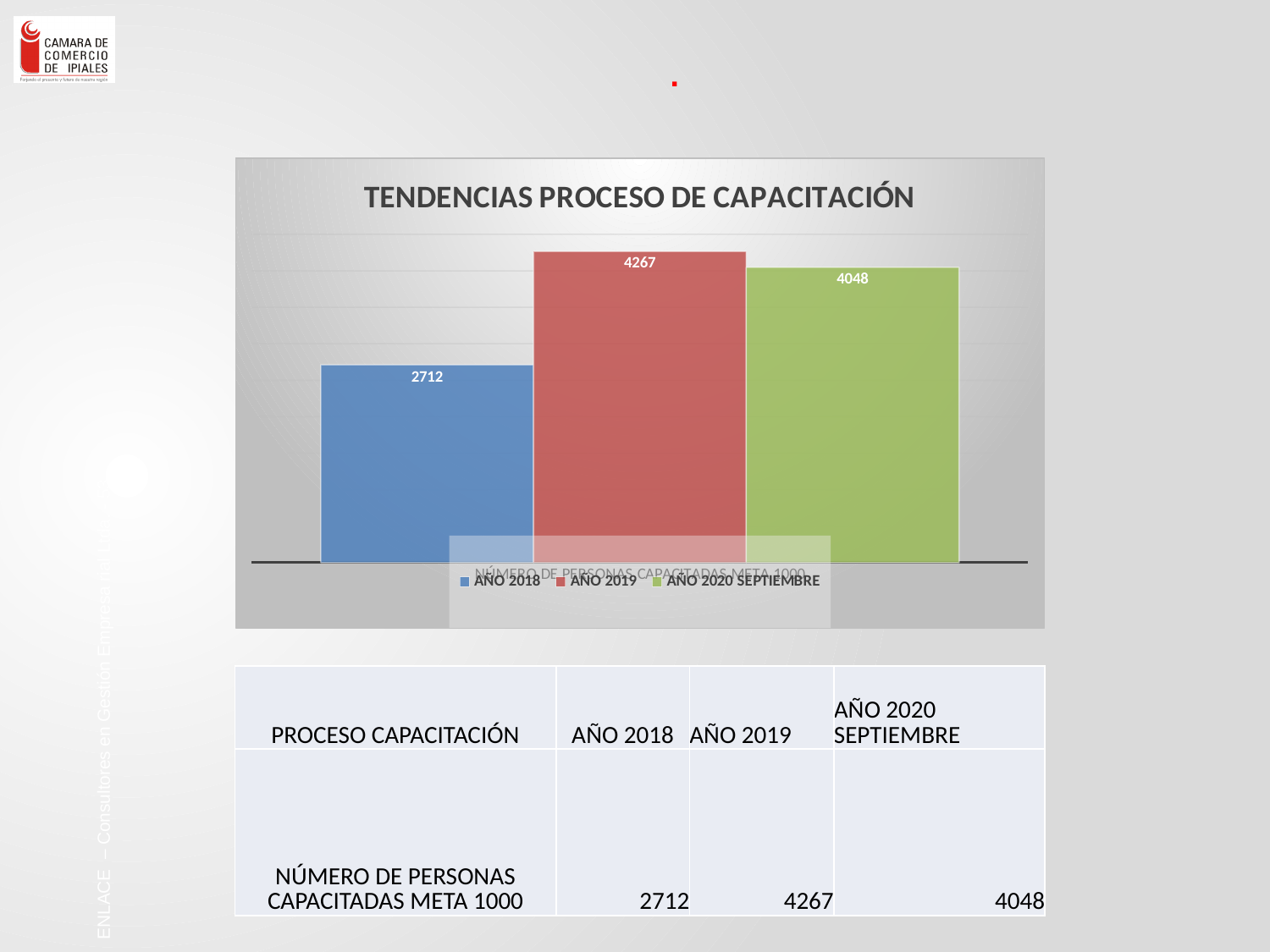
What is the value for AÑO 2020 SEPTIEMBRE in the chart? 4048 Which is larger, the value for AÑO 2018 or the value for AÑO 2020 SEPTIEMBRE? AÑO 2020 SEPTIEMBRE What kind of chart is shown on the slide? Bar chart What is the difference between the values for AÑO 2019 and AÑO 2020 SEPTIEMBRE? 219 What is the title of the chart? TENDENCIAS PROCESO DE CAPACITACIÓN What is the value for AÑO 2018 in the chart? 2712 Which series has the highest value in the chart? AÑO 2019 What colour is the bar for AÑO 2019? Red What is the value for AÑO 2019 in the chart? 4267 How many series does the legend list? 3 What is the difference between the values for AÑO 2019 and AÑO 2018? 1555 Which series has the lowest value in the chart? AÑO 2018